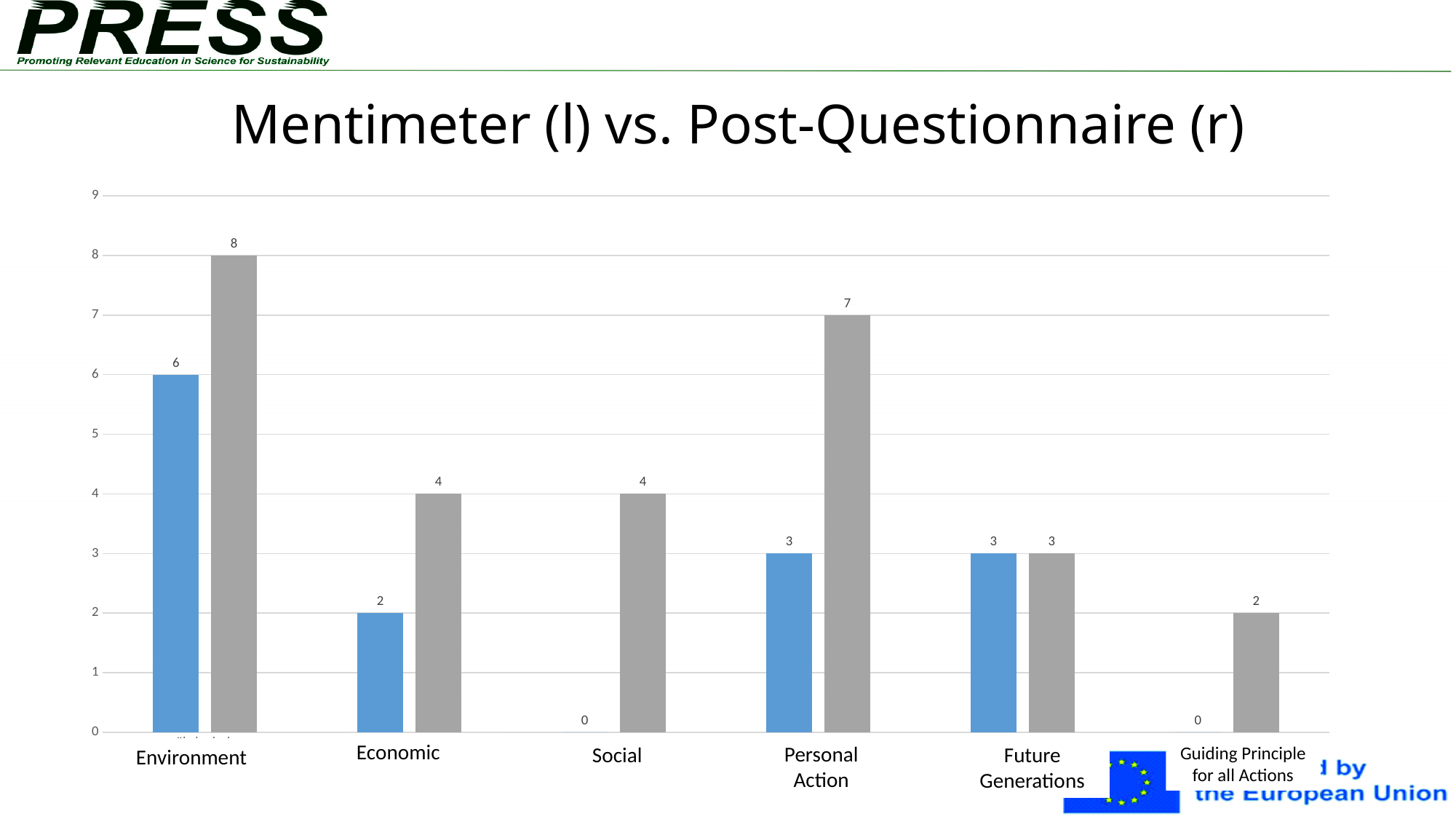
Which category has the highest Post-Questionnaire (right bar) value? Environment What is the Post-Questionnaire (right bar) value for Personal Action? 7 Which is larger for Economic: the Mentimeter value or the Post-Questionnaire value? Post-Questionnaire What is the Mentimeter (left bar) value for Guiding Principle for all Actions? 0 What kind of chart is shown on the slide? Bar chart How many categories are shown on the x axis? 6 What is the Post-Questionnaire (right bar) value for Social? 4 What is the Mentimeter (left bar) value for Environment? 6 Which category has the lowest Post-Questionnaire (right bar) value? Guiding Principle for all Actions What is the difference between the Post-Questionnaire and Mentimeter values for Personal Action? 4 What is the title of the chart? Mentimeter (l) vs. Post-Questionnaire (r) What is the difference between the Post-Questionnaire and Mentimeter values for Environment? 2